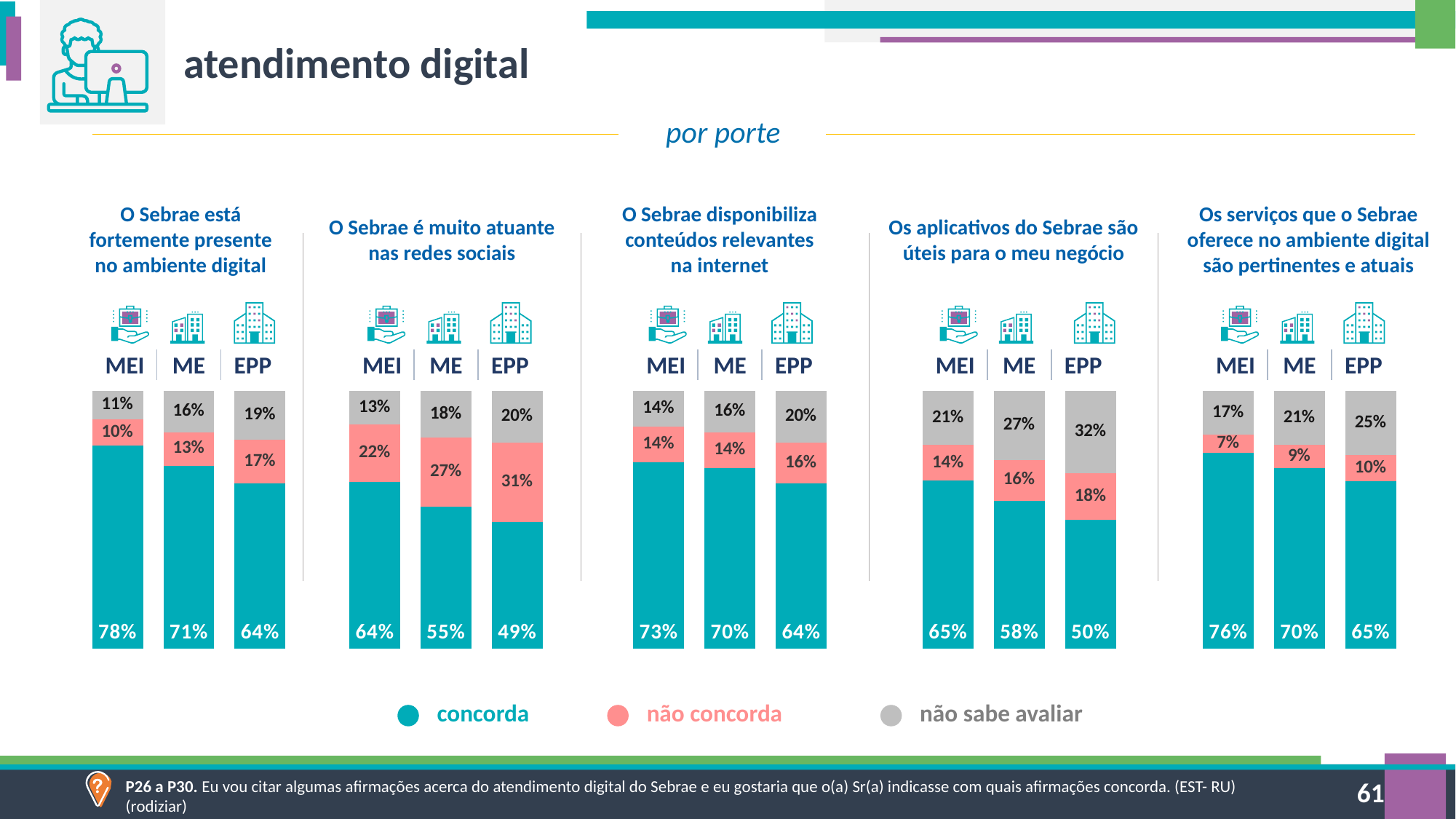
In the chart 'O Sebrae é muito atuante nas redes sociais', which category has the highest 'concorda' value? MEI Which legend entry is shown in pink? não concorda In the chart 'O Sebrae disponibiliza conteúdos relevantes na internet', what is the difference between the 'concorda' values for MEI and EPP? 9 percentage points In the chart 'Os serviços que o Sebrae oferece no ambiente digital são pertinentes e atuais', which category has the lowest 'concorda' value? EPP How many series does the legend list? 3 In the chart 'O Sebrae está fortemente presente no ambiente digital', does the 'concorda' value rise or fall from MEI to EPP? Fall In the chart 'Os aplicativos do Sebrae são úteis para o meu negócio', what is the 'não sabe avaliar' value for ME? 27% How many categories does each chart on the slide show? 3 In the chart 'O Sebrae é muito atuante nas redes sociais', what is the 'não concorda' value for EPP? 31% What kind of chart is used on this slide? Stacked bar chart In the chart 'Os aplicativos do Sebrae são úteis para o meu negócio', is the 'não sabe avaliar' value larger for MEI or for EPP? EPP In the chart 'O Sebrae está fortemente presente no ambiente digital', what is the 'concorda' value for MEI? 78%